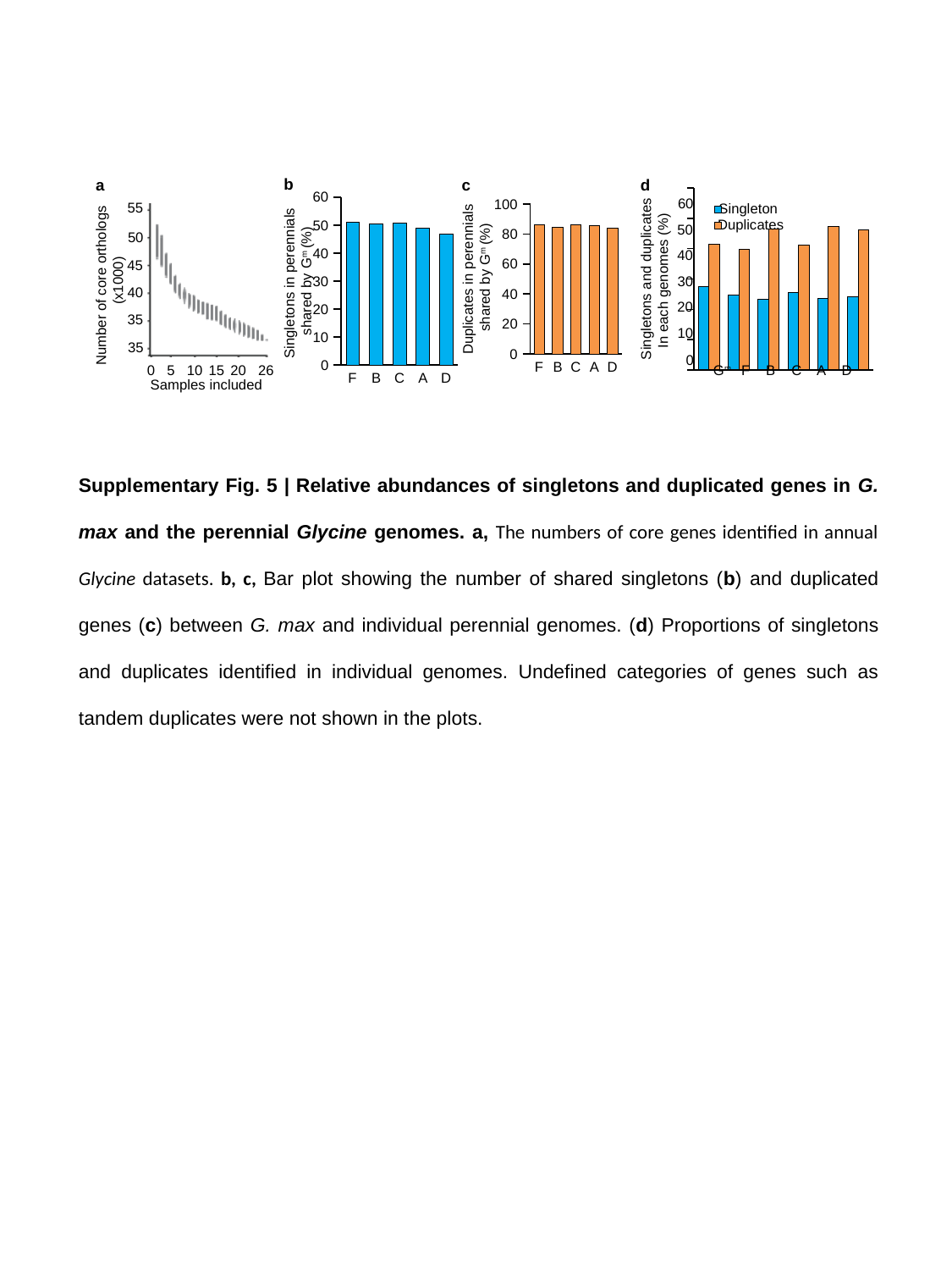
In panel d, what colour are the Duplicates bars? orange What kind of chart is panel c? bar chart In panel c, is the value for F greater or less than 80? greater In panel d, is the Duplicates value for A greater or less than 40? greater In panel b, how many categories are shown on the x axis? 5 In panel b, is the value for D greater or less than 40? greater In panel d, how many categories are shown on the x axis? 6 In panel a, do the values rise or fall as the number of samples included increases? fall In panel d, which is larger for category B, Singleton or Duplicates? Duplicates In panel d, how many series does the legend list? 2